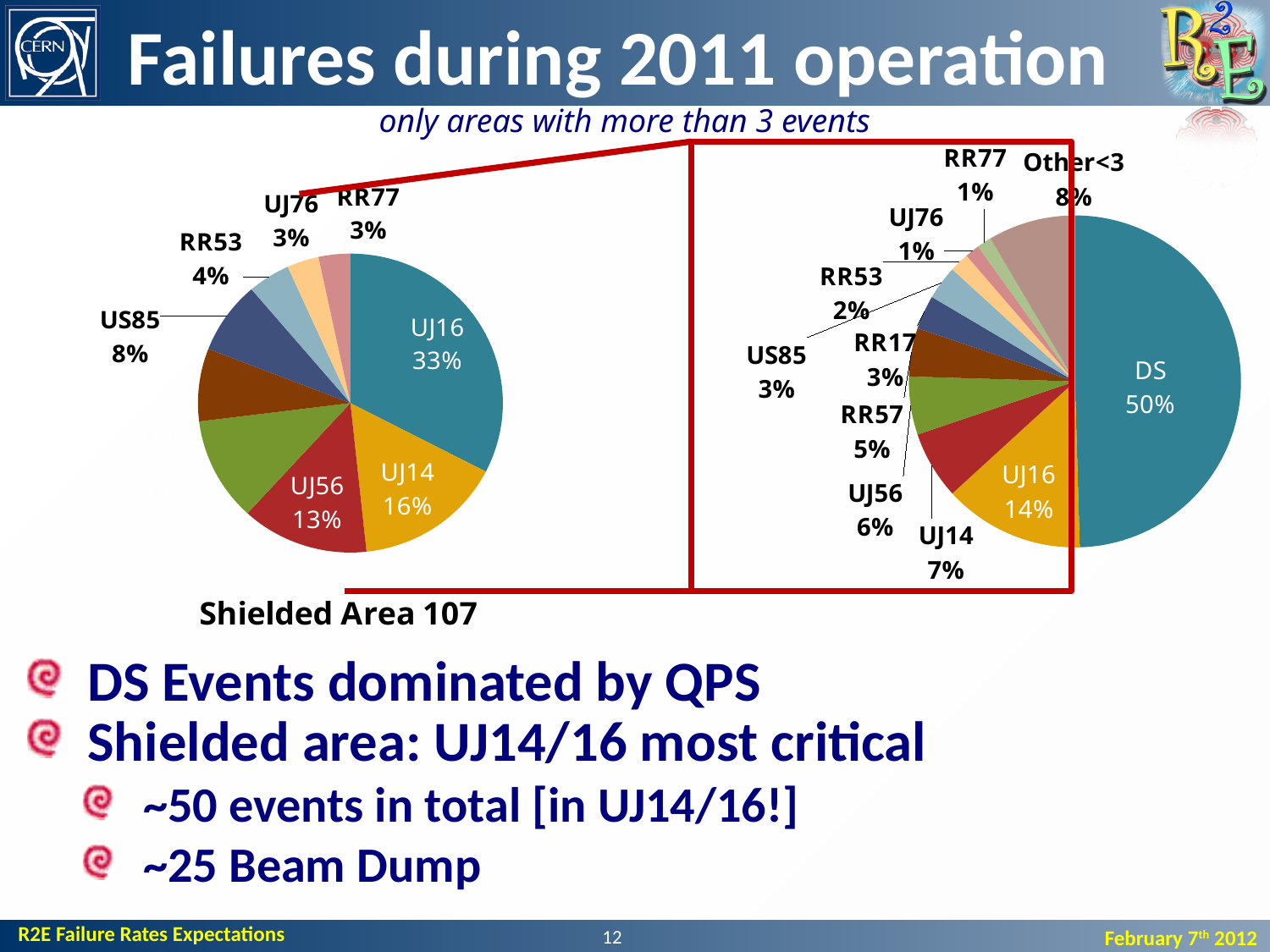
In the left pie chart (Shielded Area 107), what is the difference between the UJ16 and UJ56 shares? 20% In the left pie chart (Shielded Area 107), what share does UJ14 have? 16% In the right pie chart, what share does RR57 have? 5% In the right pie chart, which is larger, UJ14 or UJ56? UJ14 In the right pie chart, what share does UJ16 have? 14% In the right pie chart, what is the difference between the DS and UJ16 shares? 36% In the left pie chart (Shielded Area 107), what share does US85 have? 8% In the right pie chart, what share does DS have? 50% In the left pie chart (Shielded Area 107), which labelled area has the largest share? UJ16 In the right pie chart, which slice is the largest? DS What kind of charts are shown on the slide? Pie charts In the left pie chart (Shielded Area 107), what share does UJ16 have? 33%